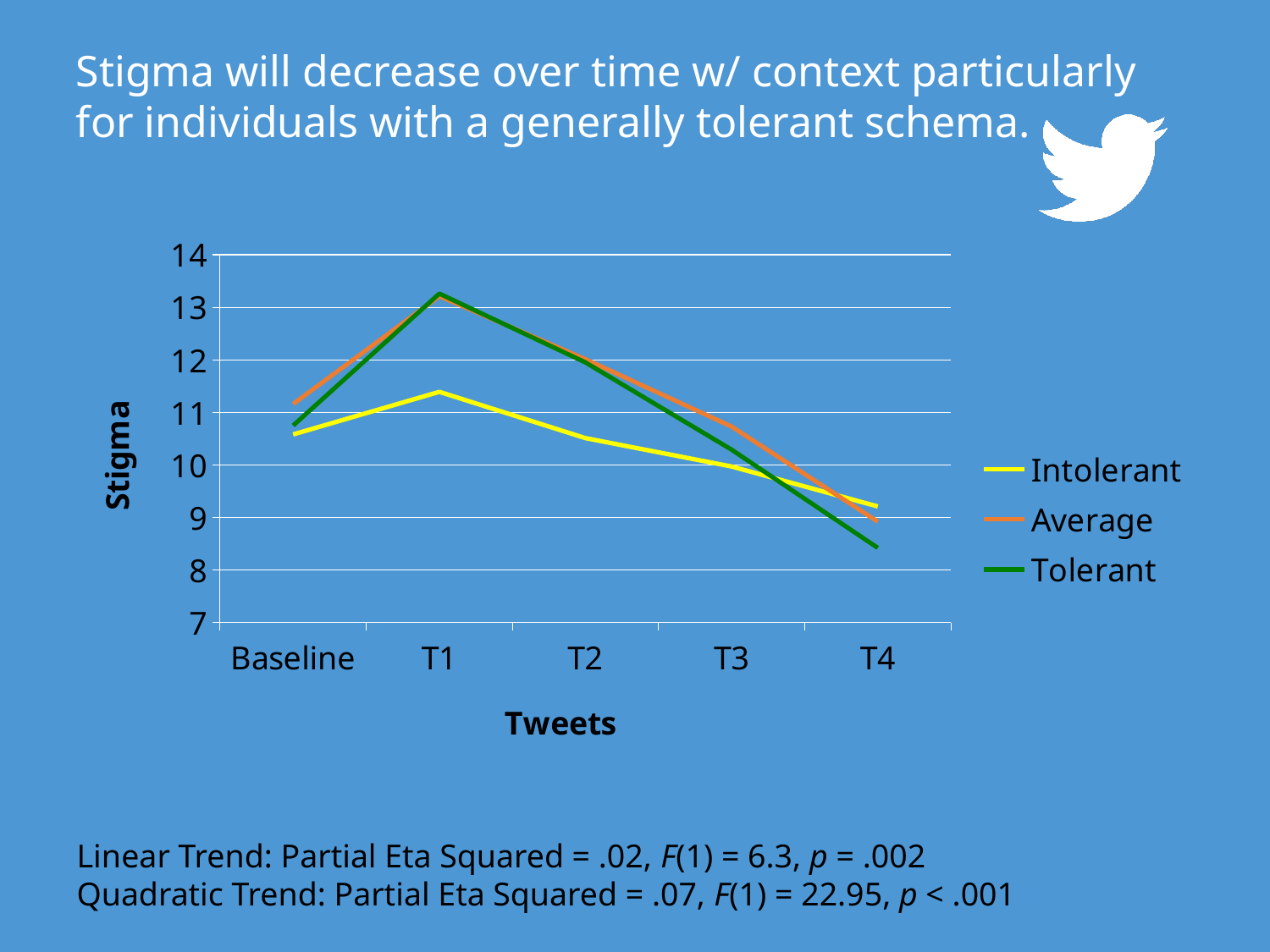
Is the Intolerant value at T1 greater or less than 11? greater How many series does the legend list? 3 What kind of chart is shown on the slide? line chart At T1, which series has the higher value, Average or Intolerant? Average Is the Average value at T1 greater or less than 13? greater What is the title of the y axis? Stigma Is the Average value at T3 greater or less than 10? greater Do the Tolerant values rise or fall from T1 to T4? fall At T4, which series has the higher value, Intolerant or Tolerant? Intolerant How many time points are shown along the x axis? 5 What is the title of the x axis? Tweets